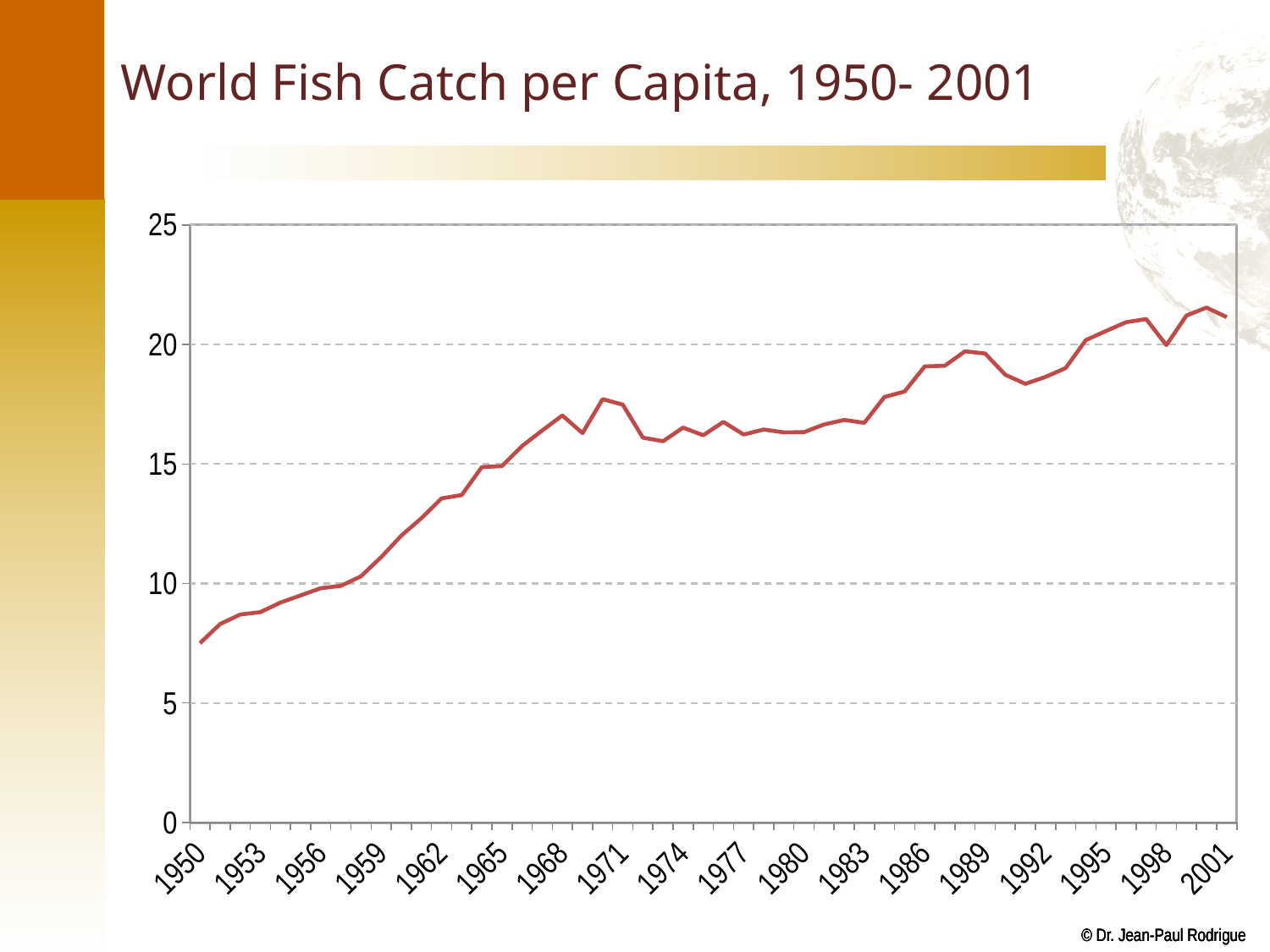
Which is larger, the value for 1989 or the value for 1992? 1989 Which year has the lowest value on the chart? 1950 Is the value for 1980 greater or less than 15? greater What is the highest value shown on the y axis? 25 Is the value for 1950 greater or less than 10? less Is the value for 2001 greater or less than 20? greater What kind of chart is shown on the slide? line chart Which is larger, the value for 1960 or the value for 1970? 1970 What is the title of the chart? World Fish Catch per Capita, 1950- 2001 Overall, do the values rise or fall from 1950 to 2001? rise